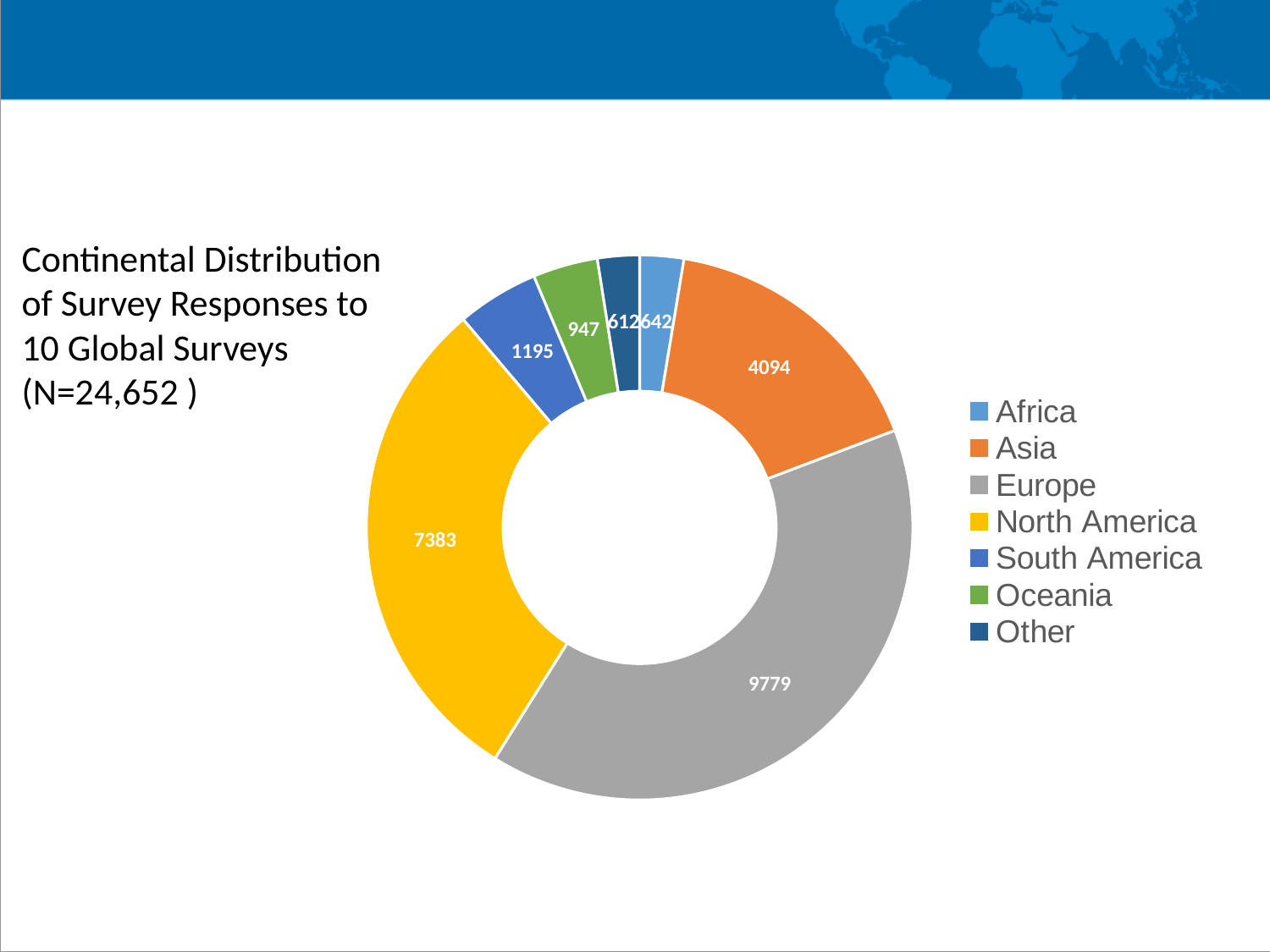
What is the difference between the values for Europe and North America? 2396 What is the value for Asia? 4094 Which is larger, the value for Asia or the value for South America? Asia What is the value for North America? 7383 What is the value for Oceania? 947 How many categories are shown in the chart? 7 Which category has the lowest number of survey responses? Other What colour represents North America in the chart? yellow What is the value for Europe? 9779 Which continent has the highest number of survey responses? Europe What kind of chart is shown on the slide? doughnut chart What is the value for South America? 1195